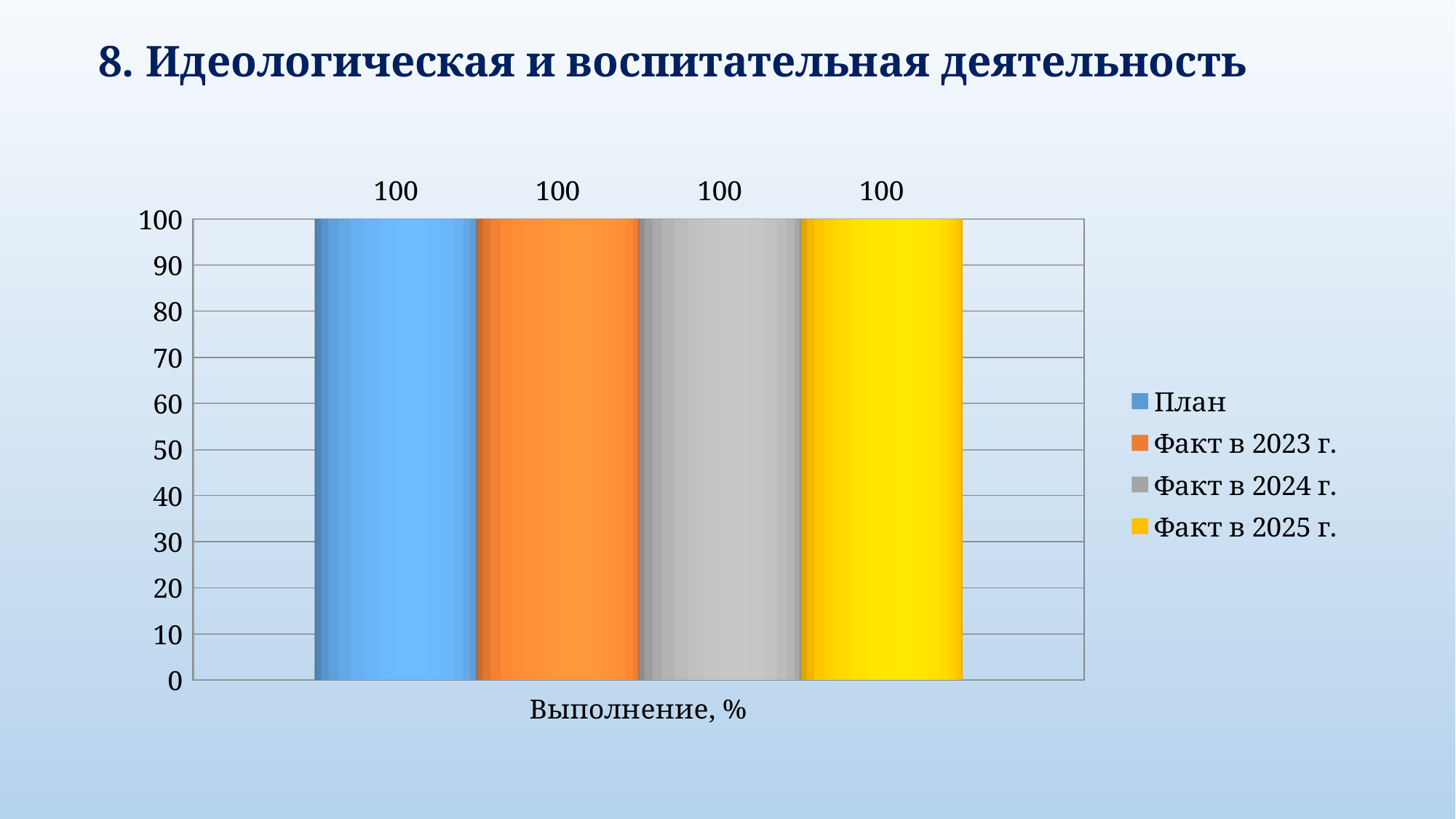
How many series does the legend list? 4 What value is shown for Факт в 2023 г.? 100 What is the highest value shown on the vertical axis? 100 What value is shown for Факт в 2024 г.? 100 What is the value of the План series for Выполнение, %? 100 What kind of chart is shown on the slide? bar chart What value is shown for Факт в 2025 г.? 100 How many categories are shown on the x axis? 1 What is the difference between the План value and the Факт в 2025 г. value? 0 Which colour represents Факт в 2025 г. in the legend? yellow Is the value for Факт в 2024 г. greater or less than 50? greater What is the label of the category on the x axis? Выполнение, %